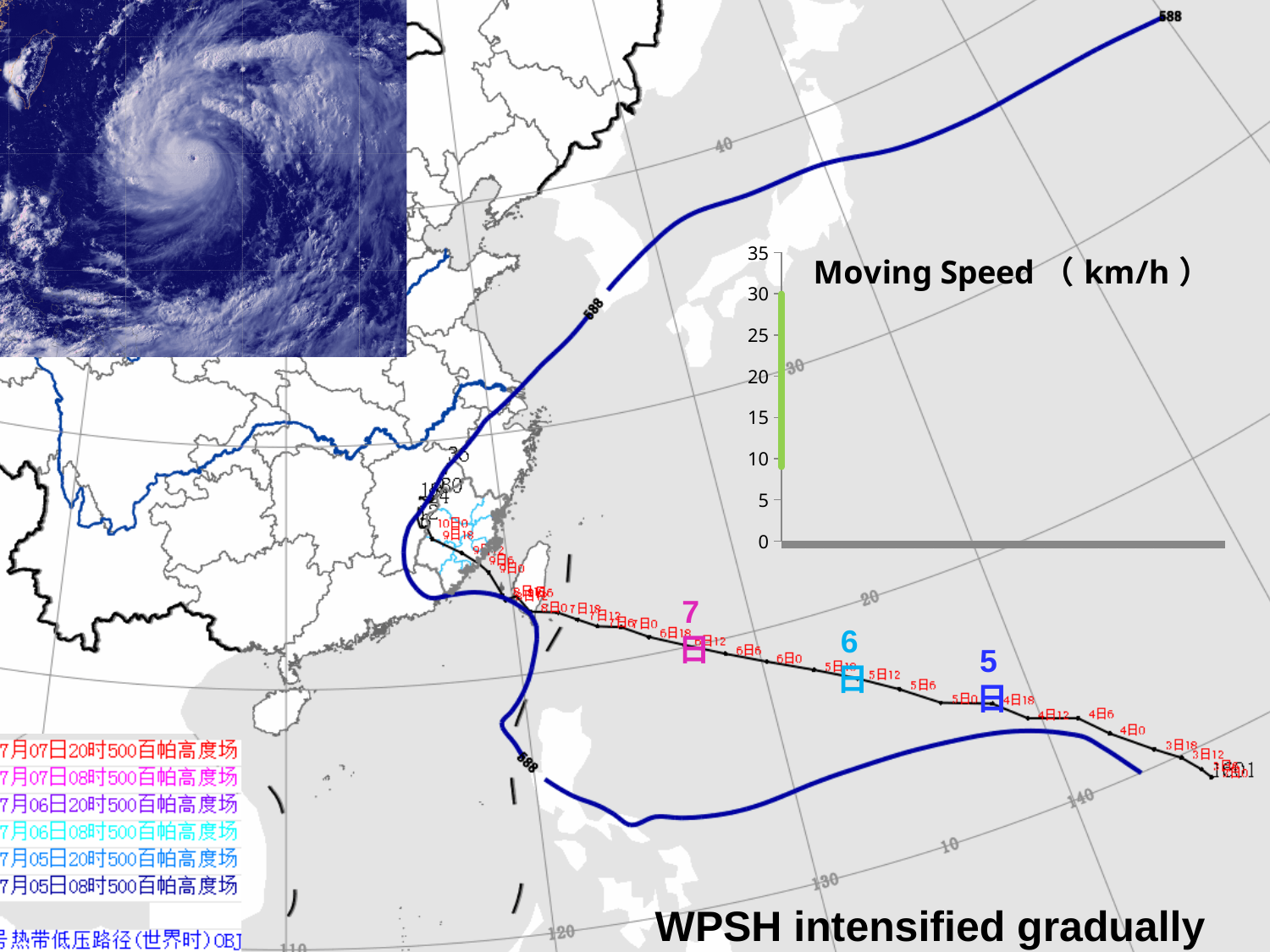
In the Moving Speed chart, how many bars are plotted? 1 In the Moving Speed chart, is the top of the green bar greater or less than 25? greater What unit is given in the title of the Moving Speed chart? km/h In the Moving Speed chart, is the bottom of the green bar greater or less than 15? less In the Moving Speed chart, is the top of the green bar greater or less than 35? less What is the title of the chart on the slide? Moving Speed (km/h)